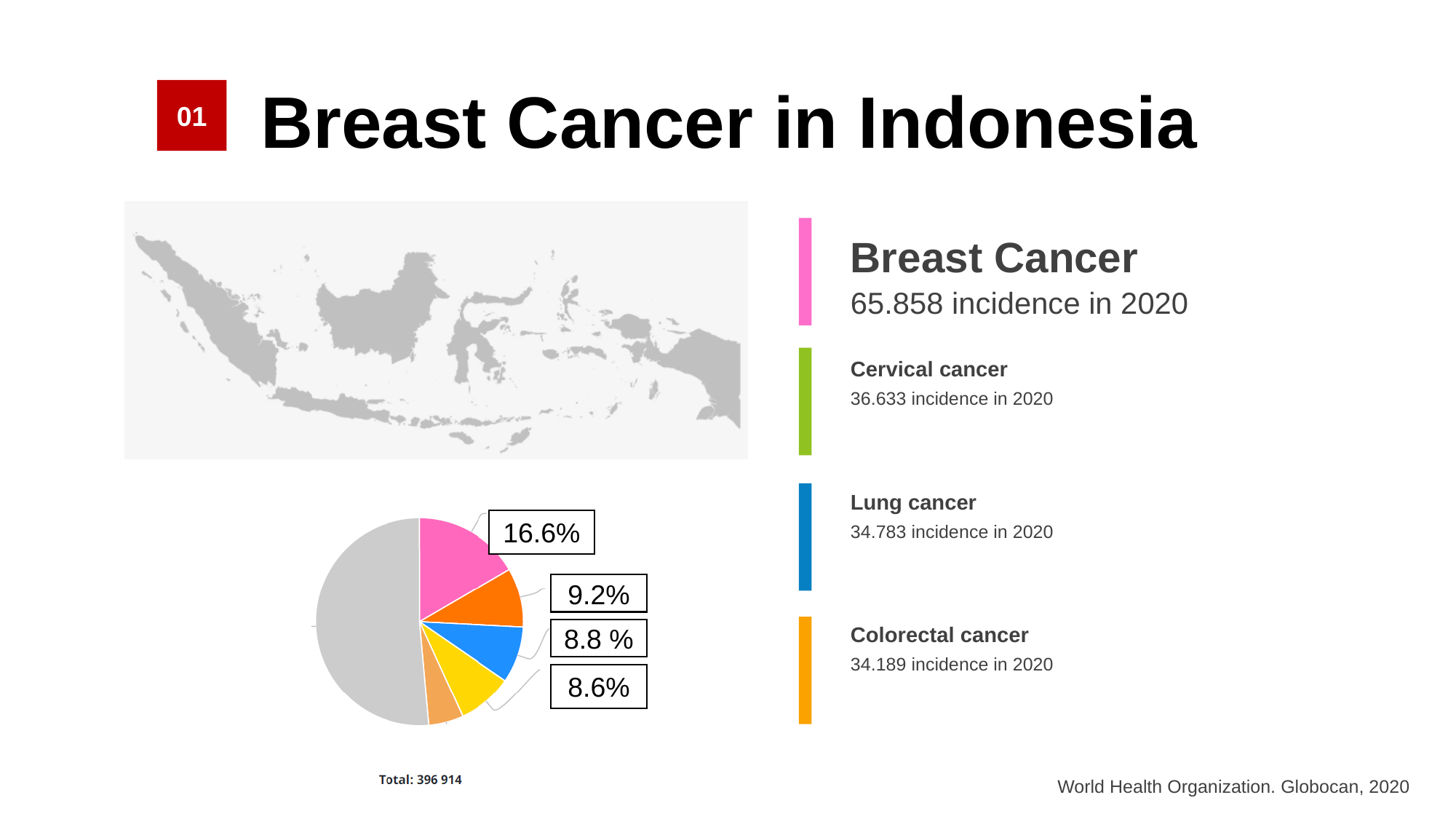
What kind of chart is shown on the slide? pie chart What percentage is labelled on the orange slice of the pie chart? 9.2% Which is larger in the pie chart, the blue slice or the yellow slice? the blue slice (8.8 %) How many slices of the pie chart have a percentage label? 4 What percentage is labelled on the blue slice of the pie chart? 8.8 % What is the difference in percentage points between the pink slice (16.6%) and the orange slice (9.2%) of the pie chart? 7.4 percentage points What percentage is labelled on the yellow slice of the pie chart? 8.6% What colour is the largest labelled slice of the pie chart? pink Which labelled slice of the pie chart has the largest percentage? 16.6% (pink slice) Which labelled slice of the pie chart has the smallest percentage? 8.6% (yellow slice) What percentage is labelled on the pink slice of the pie chart? 16.6% What total is printed below the pie chart? Total: 396 914